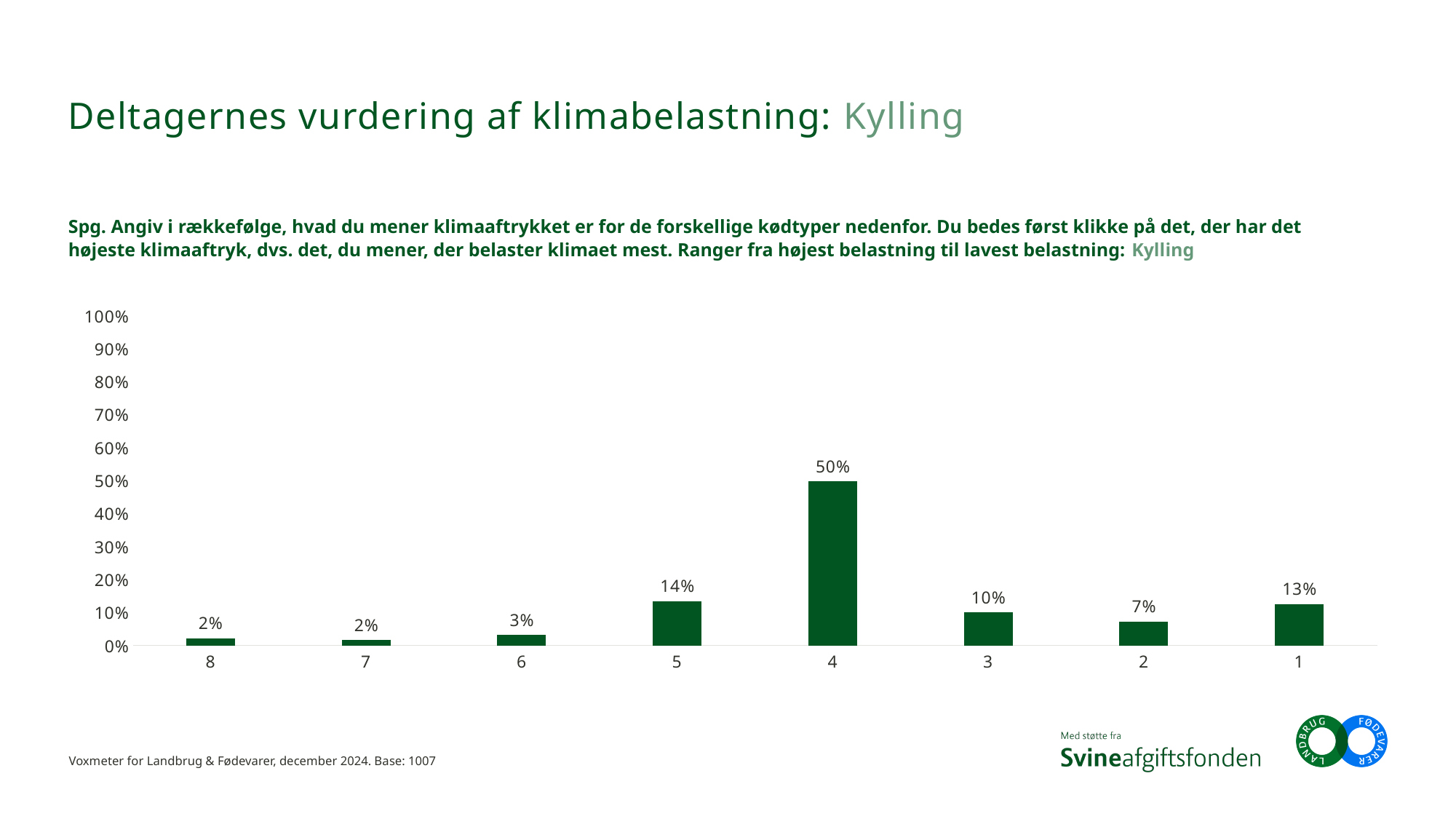
Is the value for category 4 greater or less than 40%? greater What is the value for category 6? 3% What is the value for category 4? 50% What is the difference between the values for category 4 and category 5? 36% What is the difference between the values for category 1 and category 2? 6% What is the value for category 5? 14% Which is larger, the value for category 3 or the value for category 2? 3 How many categories are shown on the x axis? 8 What kind of chart is shown on the slide? bar chart Which category has the highest value? 4 What is the value for category 1? 13% Is the value for category 1 greater or less than 20%? less